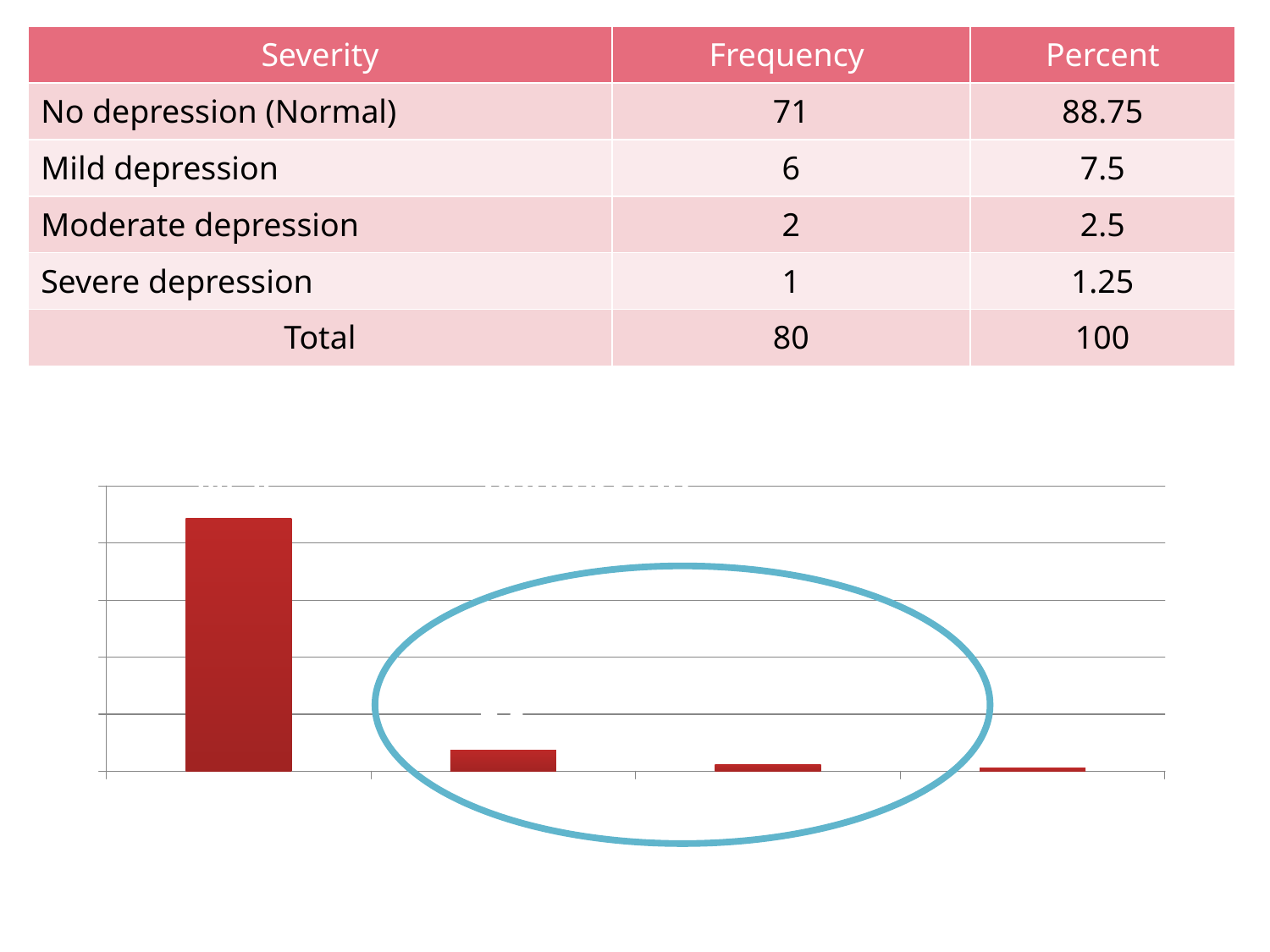
What kind of chart is shown at the bottom of the slide? bar chart In the chart at the bottom of the slide, do the bar heights rise or fall from left to right? fall What colour are the bars in the chart at the bottom of the slide? red In the chart at the bottom of the slide, is the first bar or the second bar taller? the first bar In the chart at the bottom of the slide, how many bars are enclosed by the blue oval? 2 In the chart at the bottom of the slide, which bar is the shortest? the fourth (rightmost) bar How many bars does the chart at the bottom of the slide have? 4 In the chart at the bottom of the slide, which bar is the tallest? the first (leftmost) bar